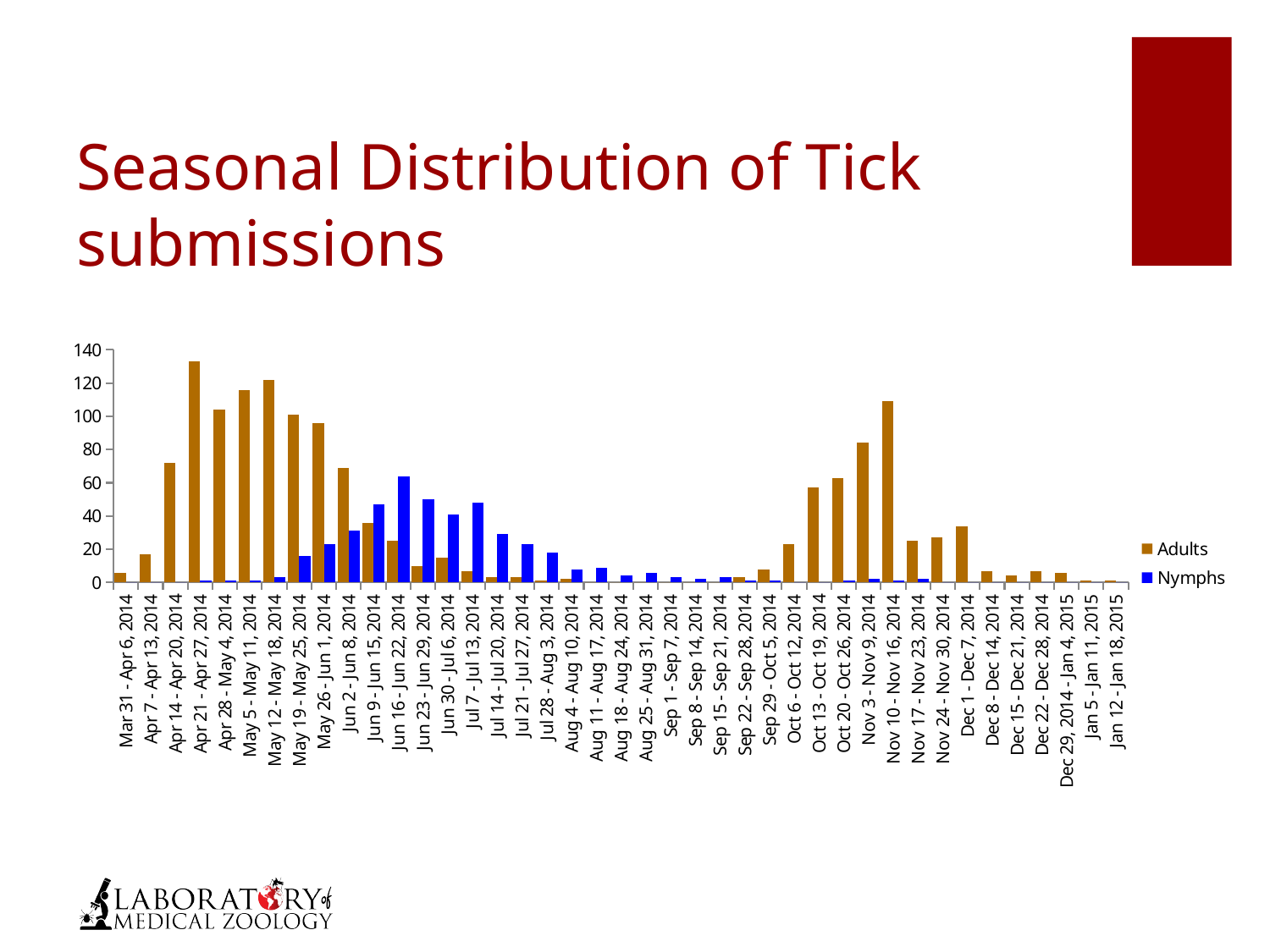
Which is larger, the Adults value for Apr 21 - Apr 27, 2014 or for May 12 - May 18, 2014? Apr 21 - Apr 27, 2014 What colour are the Nymphs bars? Blue Is the Adults value for Apr 21 - Apr 27, 2014 greater or less than 120? greater Which week has the highest value for Nymphs? Jun 16 - Jun 22, 2014 Which week has the highest value for Adults? Apr 21 - Apr 27, 2014 Is the Adults value for Jun 9 - Jun 15, 2014 greater or less than 40? less Is the Adults value for Nov 10 - Nov 16, 2014 greater or less than 100? greater Which is larger, the Nymphs value for Jun 16 - Jun 22, 2014 or for Jun 23 - Jun 29, 2014? Jun 16 - Jun 22, 2014 Do the Nymphs values rise or fall from Jun 16 - Jun 22, 2014 to Aug 4 - Aug 10, 2014? Fall How many series does the legend list? 2 What kind of chart is shown on the slide? Bar chart